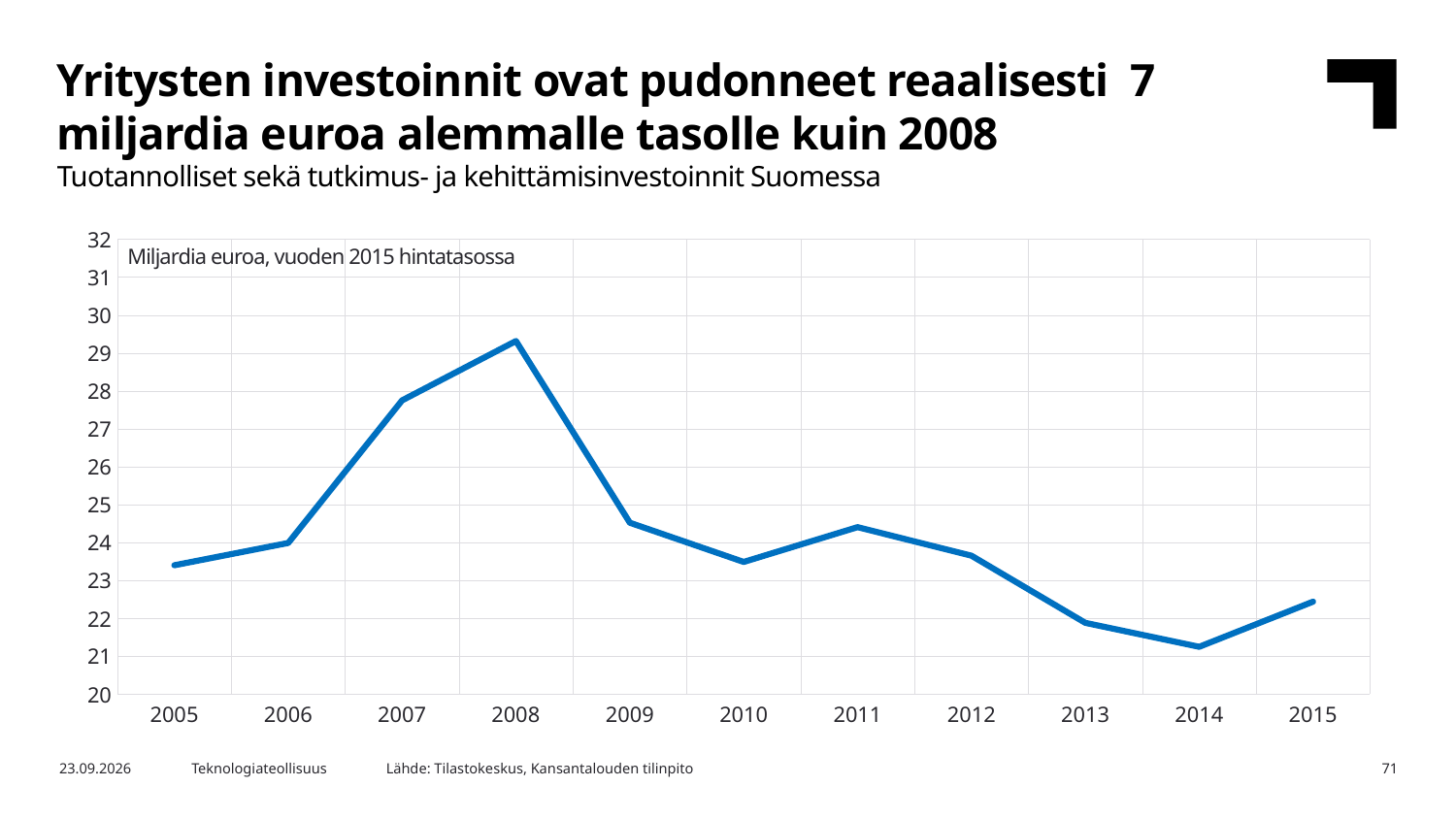
Which year has the highest value? 2008 Is the value for 2007 greater or less than 27? greater Is the value for 2008 greater or less than 29? greater Is the value for 2014 greater or less than 22? less Do the values rise or fall from 2008 to 2010? fall Which year has the larger value, 2011 or 2013? 2011 What kind of chart is shown on the slide? line chart Which year has the lowest value? 2014 Which year has the larger value, 2007 or 2009? 2007 What unit is stated in the label inside the chart area? Miljardia euroa, vuoden 2015 hintatasossa How many years are plotted on the x axis? 11